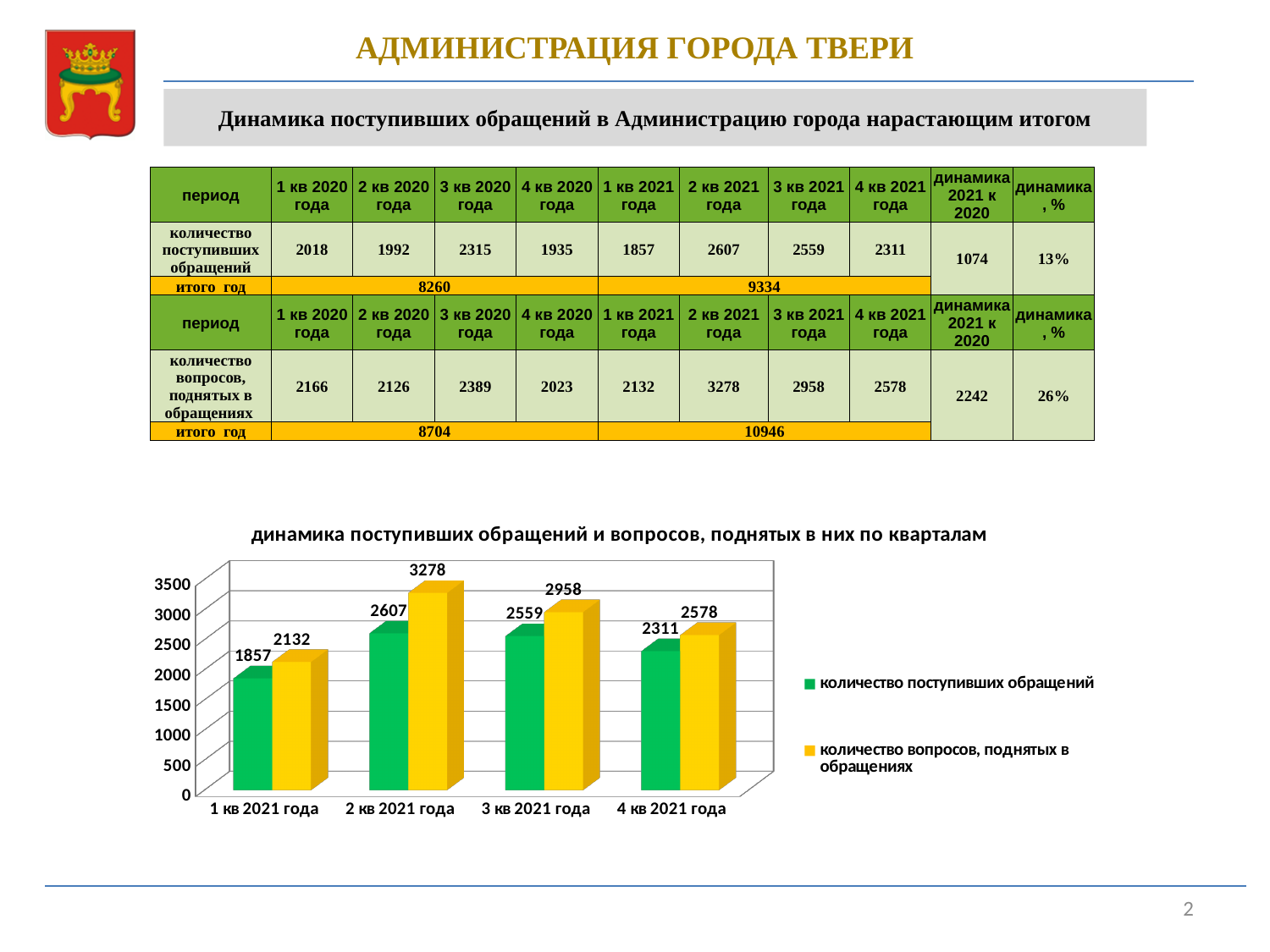
How many series does the chart legend list? 2 What is the difference between 'количество вопросов, поднятых в обращениях' and 'количество поступивших обращений' in 3 кв 2021 года? 399 How many quarters (categories) are shown on the x axis of the chart? 4 Which is larger: 'количество поступивших обращений' in 2 кв 2021 года or in 3 кв 2021 года? 2 кв 2021 года What is the value of 'количество поступивших обращений' for 4 кв 2021 года? 2311 In which quarter is 'количество вопросов, поднятых в обращениях' the highest? 2 кв 2021 года What is the value of 'количество поступивших обращений' for 1 кв 2021 года? 1857 What type of chart is shown on the slide? bar chart Is the value of 'количество вопросов, поднятых в обращениях' for 4 кв 2021 года greater or less than 2500? greater What is the title of the chart? динамика поступивших обращений и вопросов, поднятых в них по кварталам In which quarter is 'количество поступивших обращений' the lowest? 1 кв 2021 года What is the value of 'количество вопросов, поднятых в обращениях' for 2 кв 2021 года? 3278